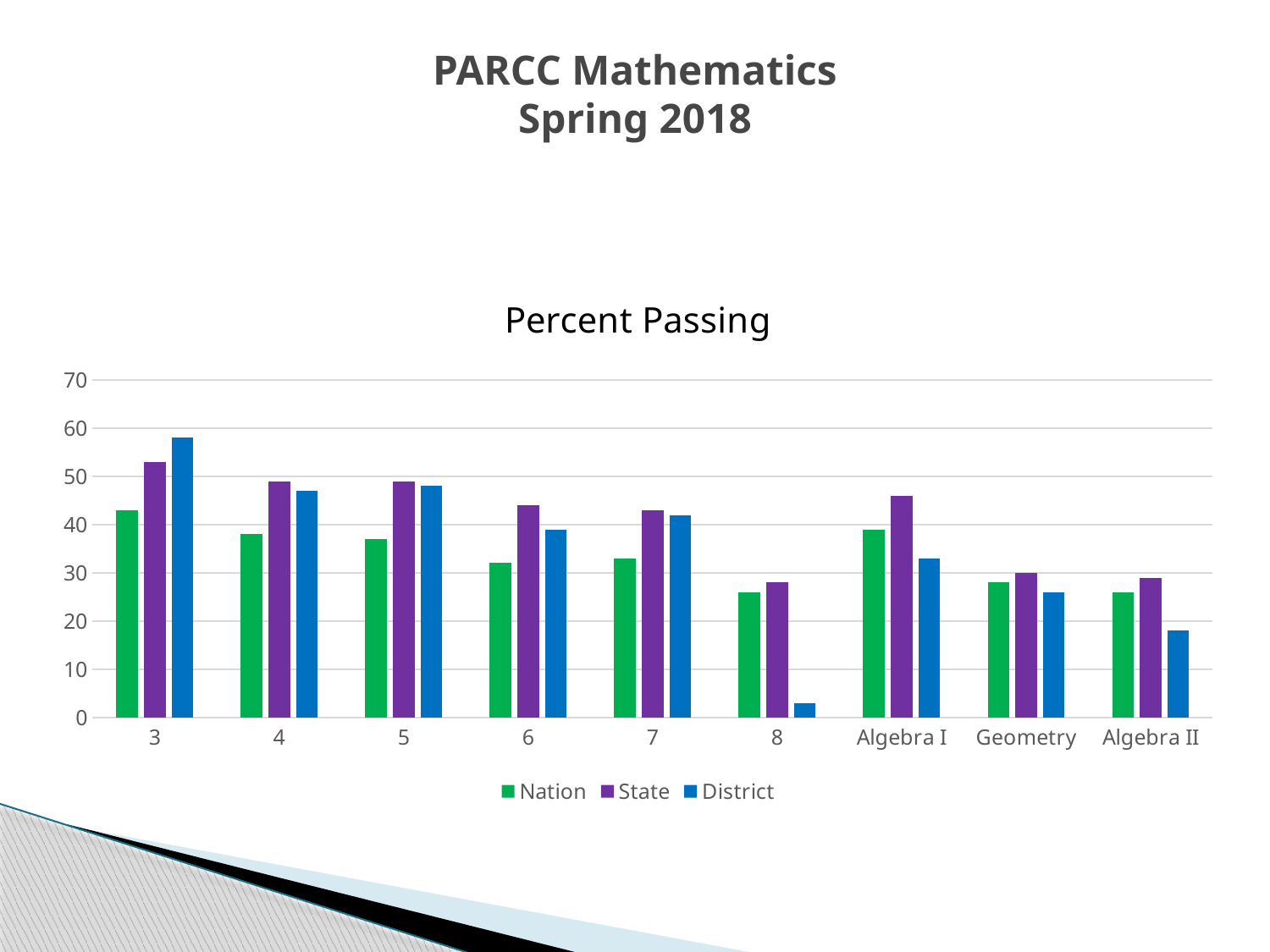
How many series does the legend list? 3 Which category has the highest State bar? 3 Is the State value for grade 6 greater or less than 40? greater Is the District value for grade 3 greater or less than 50? greater What is the title of the chart? Percent Passing For grade 3, which is larger: the Nation value or the District value? District How many categories are shown along the x axis of the chart? 9 Which category has the highest District bar? 3 What kind of chart is shown on the slide? bar chart Which category has the lowest District bar? 8 For Algebra I, which is larger: the State value or the District value? State Is the Nation value for grade 8 greater or less than 30? less